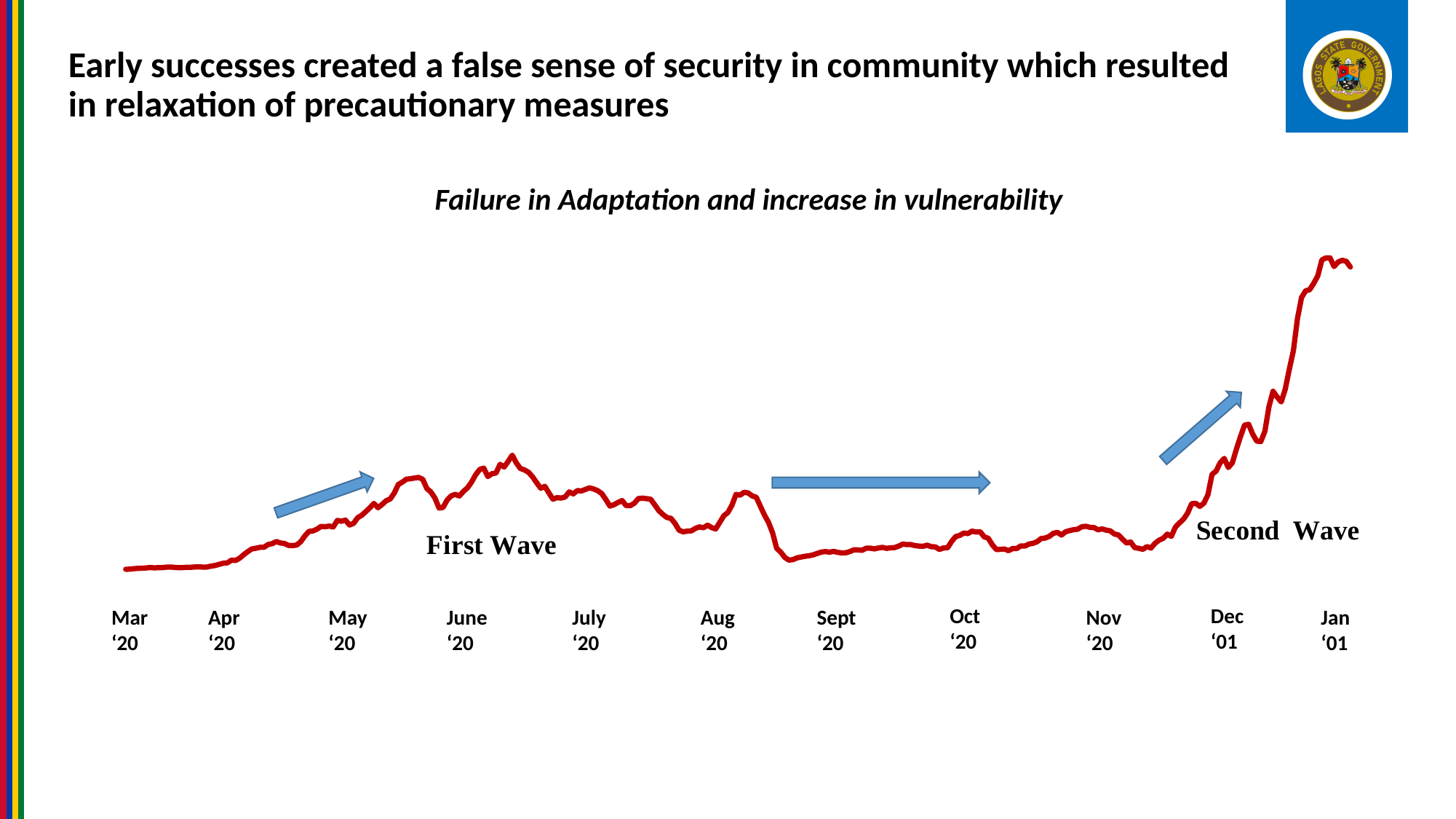
Is the peak of the Second Wave higher or lower than the peak of the First Wave? Higher Does the line rise or fall between June '20 and Sept '20? Falls What is the first month label on the x axis of the chart? Mar '20 Does the line rise or fall between Nov '20 and Jan '01? Rises What are the two wave labels annotated on the chart? First Wave and Second Wave Which month label on the x axis corresponds to the lowest point of the line? Mar '20 How many lines are plotted on the chart? 1 What kind of chart is shown on the slide? Line chart Which month label on the x axis corresponds to the highest point of the line? Jan '01 How many month labels are shown along the x axis of the chart? 11 Does the line rise or fall between Mar '20 and June '20? Rises What is the title of the chart? Failure in Adaptation and increase in vulnerability